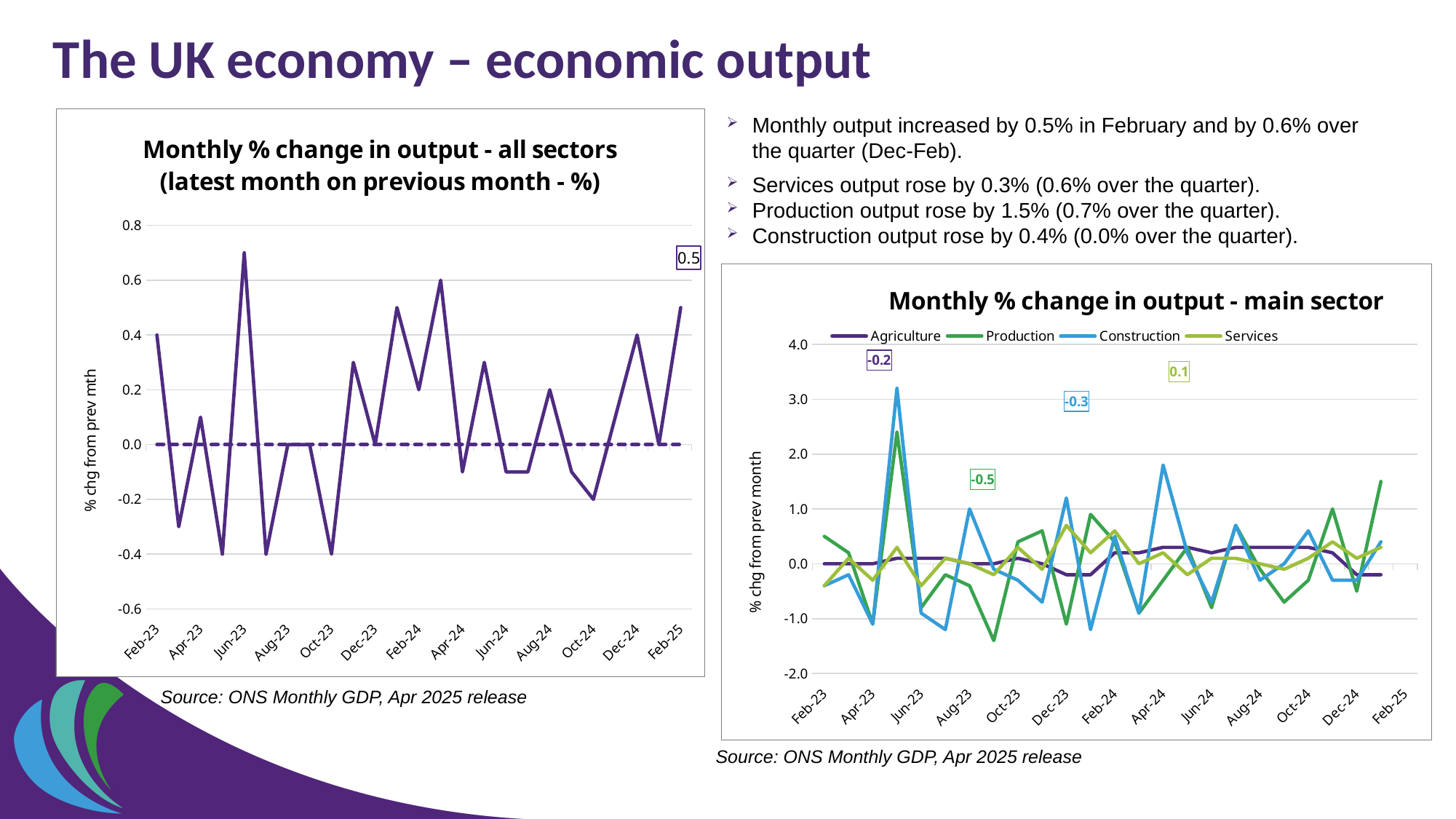
What kind of chart is the 'Monthly % change in output - all sectors' chart? Line chart How many series does the legend of the 'Monthly % change in output - main sector' chart list? 4 In the 'Monthly % change in output - main sector' chart, which series reaches the highest peak? Construction In the 'Monthly % change in output - all sectors' chart, which is larger, the value for Jun-23 or the value for Apr-24? Jun-23 What is the source cited beneath the 'Monthly % change in output - main sector' chart? ONS Monthly GDP, Apr 2025 release In the 'Monthly % change in output - all sectors' chart, which month has the highest value? Jun-23 In the 'Monthly % change in output - all sectors' chart, is the value for Oct-23 greater or less than -0.2? less What kind of chart is the 'Monthly % change in output - main sector' chart? Line chart In the 'Monthly % change in output - all sectors' chart, is the value for Jun-23 greater or less than 0.6? greater What are the series named in the legend of the 'Monthly % change in output - main sector' chart? Agriculture, Production, Construction, Services In the 'Monthly % change in output - all sectors' chart, what is the labelled value for Feb-25? 0.5 In the 'Monthly % change in output - main sector' chart, is the Construction value at its peak in mid-2023 greater or less than 2.0? greater